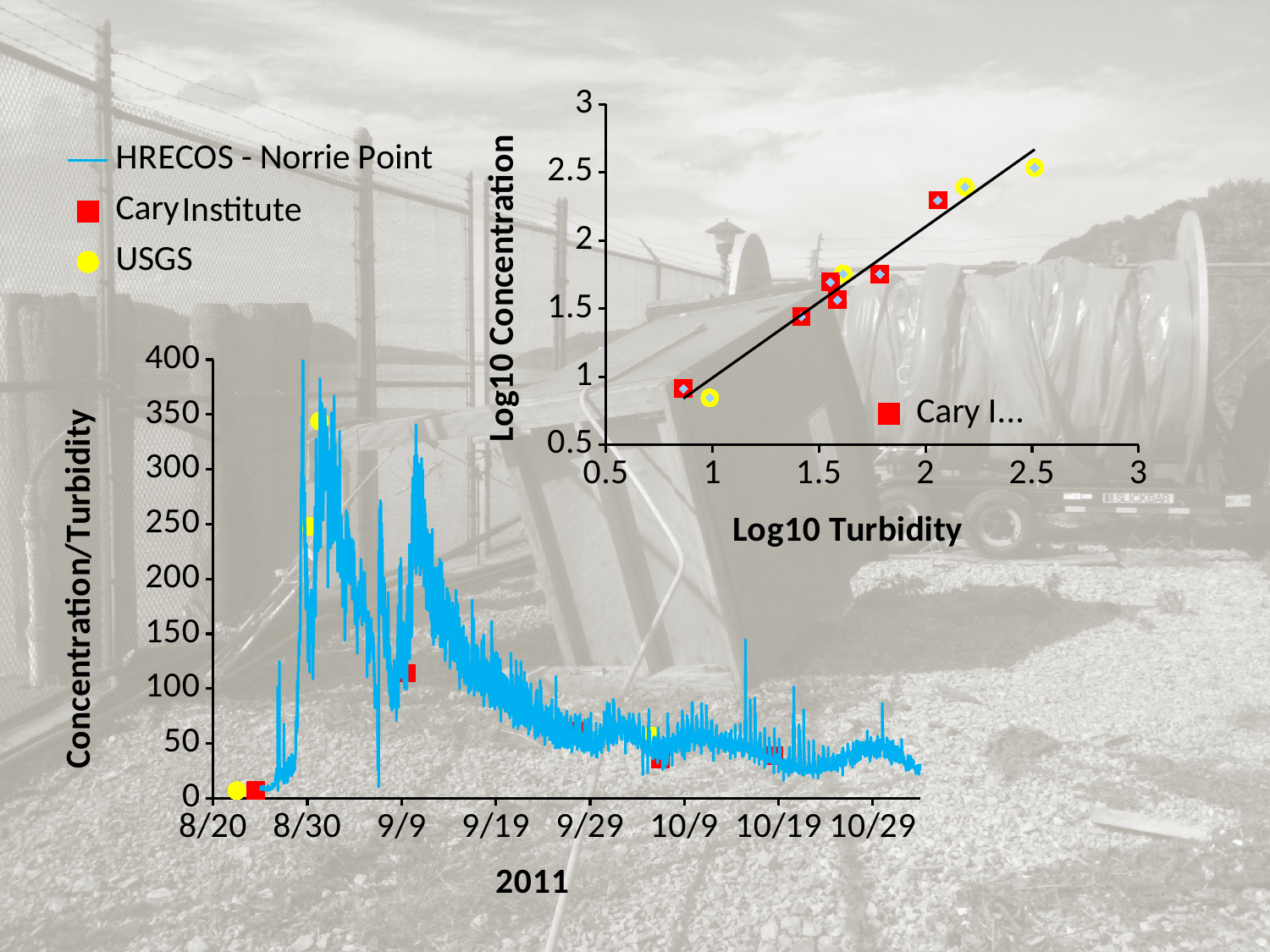
In the upper-right chart, is the Log10 Concentration of the point with the highest Log10 Turbidity greater or less than 2? greater What kind of chart is the chart in the upper right with the x axis labelled Log10 Turbidity? scatter chart In the lower-left chart, is the USGS value plotted just after 8/20 greater or less than 50? less In the upper-right chart, what is the x-axis title? Log10 Turbidity In the lower-left chart, what is the y-axis title? Concentration/Turbidity In the upper-right chart, does Log10 Concentration rise or fall as Log10 Turbidity increases? rise In the lower-left chart, do the HRECOS - Norrie Point values rise or fall between 9/19 and 10/29? fall What kind of chart is the chart in the lower left with the x axis labelled 2011? line chart In the lower-left chart, is the highest value of the HRECOS - Norrie Point line greater or less than 300? greater In the lower-left chart, how many series does the legend list? 3